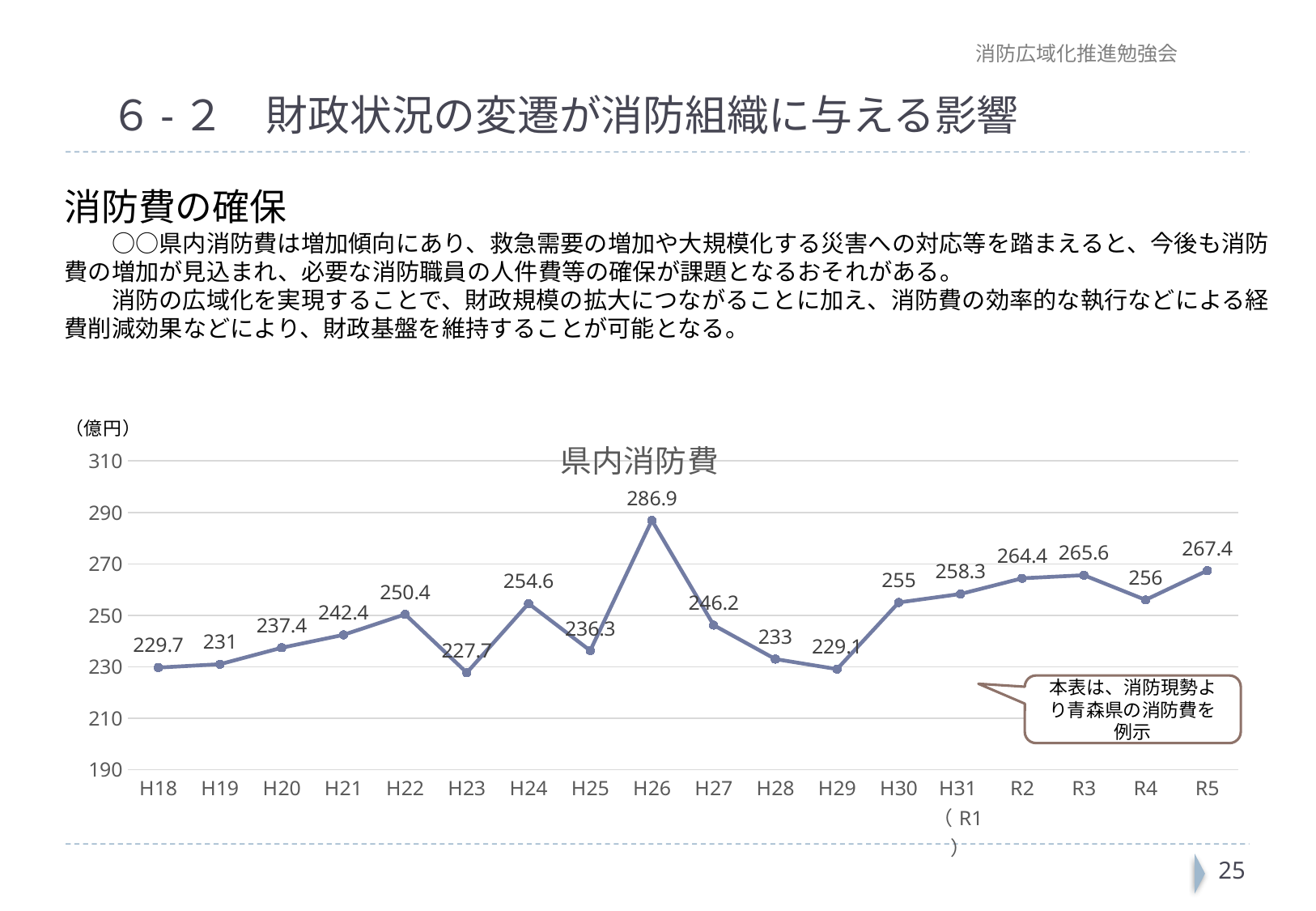
What is the difference between the values for R5 and H18? 37.7 What is the value for H23 in the 県内消防費 chart? 227.7 What type of chart is shown on the slide? line chart Which year has the highest value in the 県内消防費 chart? H26 Which is larger, the value for H22 or the value for H24? H24 What is the difference between the values for H26 and H27? 40.7 What unit is shown for the values in the chart? 億円 What is the value for R5 in the 県内消防費 chart? 267.4 Which year has the lowest value in the 県内消防費 chart? H23 How many data points are plotted in the 県内消防費 chart? 18 What is the title of the chart? 県内消防費 What is the value for H26 in the 県内消防費 chart? 286.9